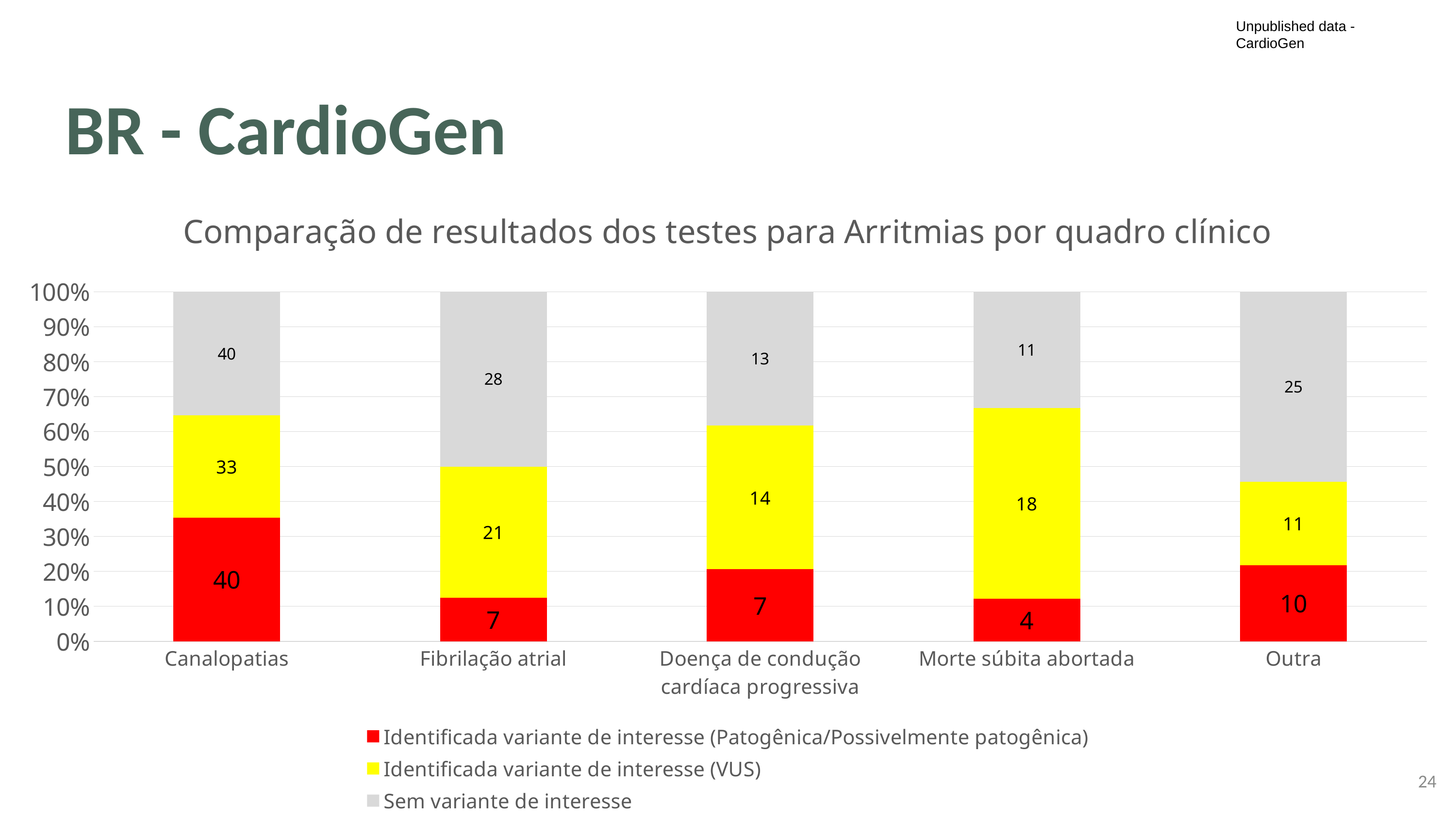
Which category has the lowest labelled value for 'Sem variante de interesse'? Morte súbita abortada What is the difference between the 'Sem variante de interesse' values for Canalopatias and Fibrilação atrial? 12 Which is larger: the VUS value for Morte súbita abortada or the VUS value for Doença de condução cardíaca progressiva? Morte súbita abortada How many series does the legend list? 3 How many clinical categories are shown on the x axis? 5 What type of chart is shown on the slide? stacked bar chart What is the value labelled for 'Sem variante de interesse' in the Outra bar? 25 Is the share of the Canalopatias bar taken by the red 'Patogênica/Possivelmente patogênica' segment greater or less than 30%? greater Which category has the highest labelled value for 'Identificada variante de interesse (Patogênica/Possivelmente patogênica)'? Canalopatias What is the total of the three labelled values in the Canalopatias bar? 113 What is the value labelled for 'Identificada variante de interesse (Patogênica/Possivelmente patogênica)' in the Morte súbita abortada bar? 4 What is the value labelled for 'Identificada variante de interesse (VUS)' in the Fibrilação atrial bar? 21